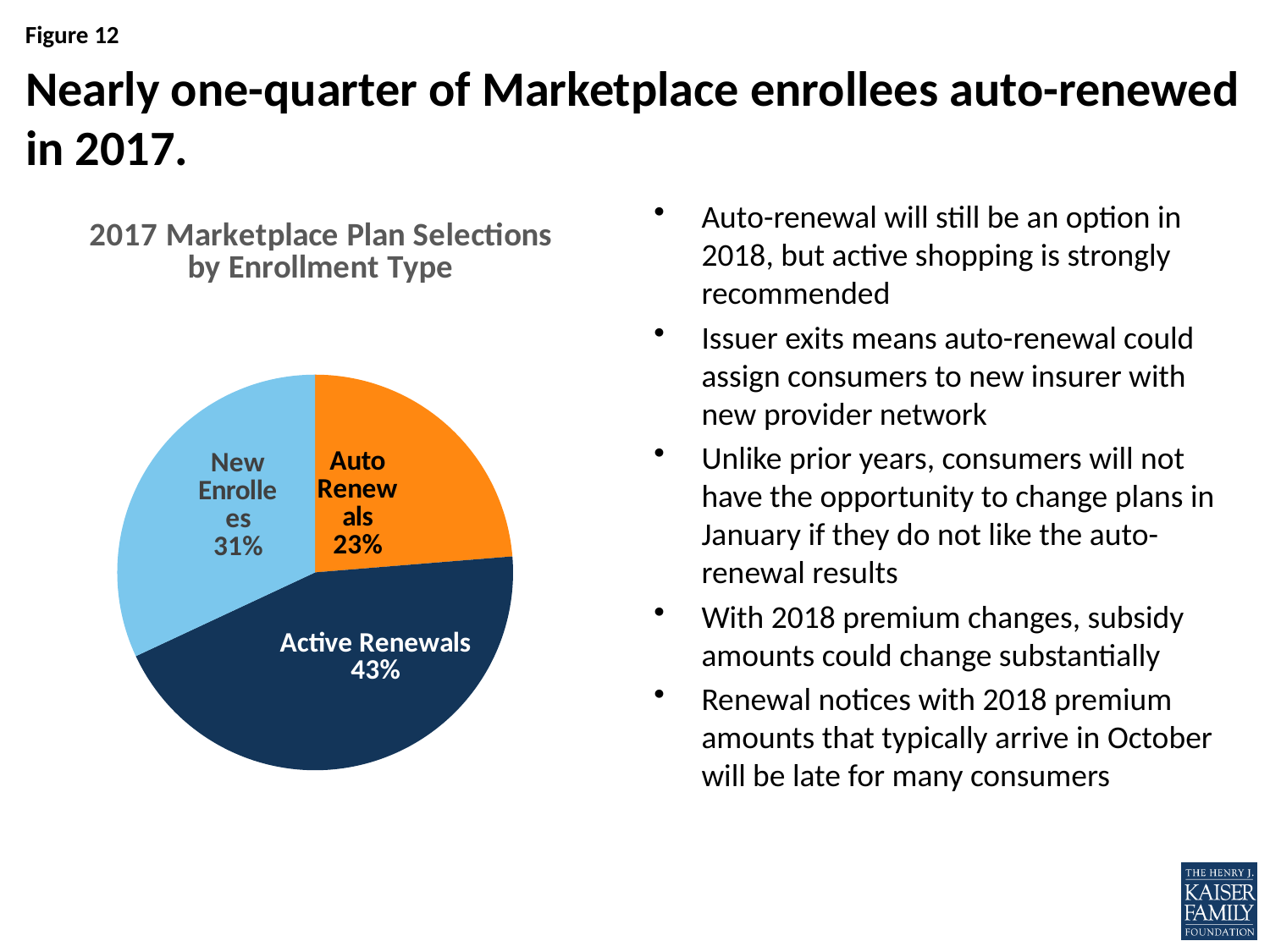
Which is larger, the share for New Enrollees or the share for Auto Renewals? New Enrollees What colour is the Active Renewals slice? dark navy blue What is the title of the chart? 2017 Marketplace Plan Selections by Enrollment Type What share of 2017 Marketplace plan selections were Auto Renewals? 23% What is the difference in percentage points between Active Renewals and Auto Renewals? 20 percentage points Which enrollment type has the largest share of the pie? Active Renewals What share of 2017 Marketplace plan selections were New Enrollees? 31% What kind of chart is shown on the slide? pie chart Which enrollment type has the smallest share of the pie? Auto Renewals What share of 2017 Marketplace plan selections were Active Renewals? 43% What is the difference in percentage points between New Enrollees and Auto Renewals? 8 percentage points How many slices does the pie chart have? 3